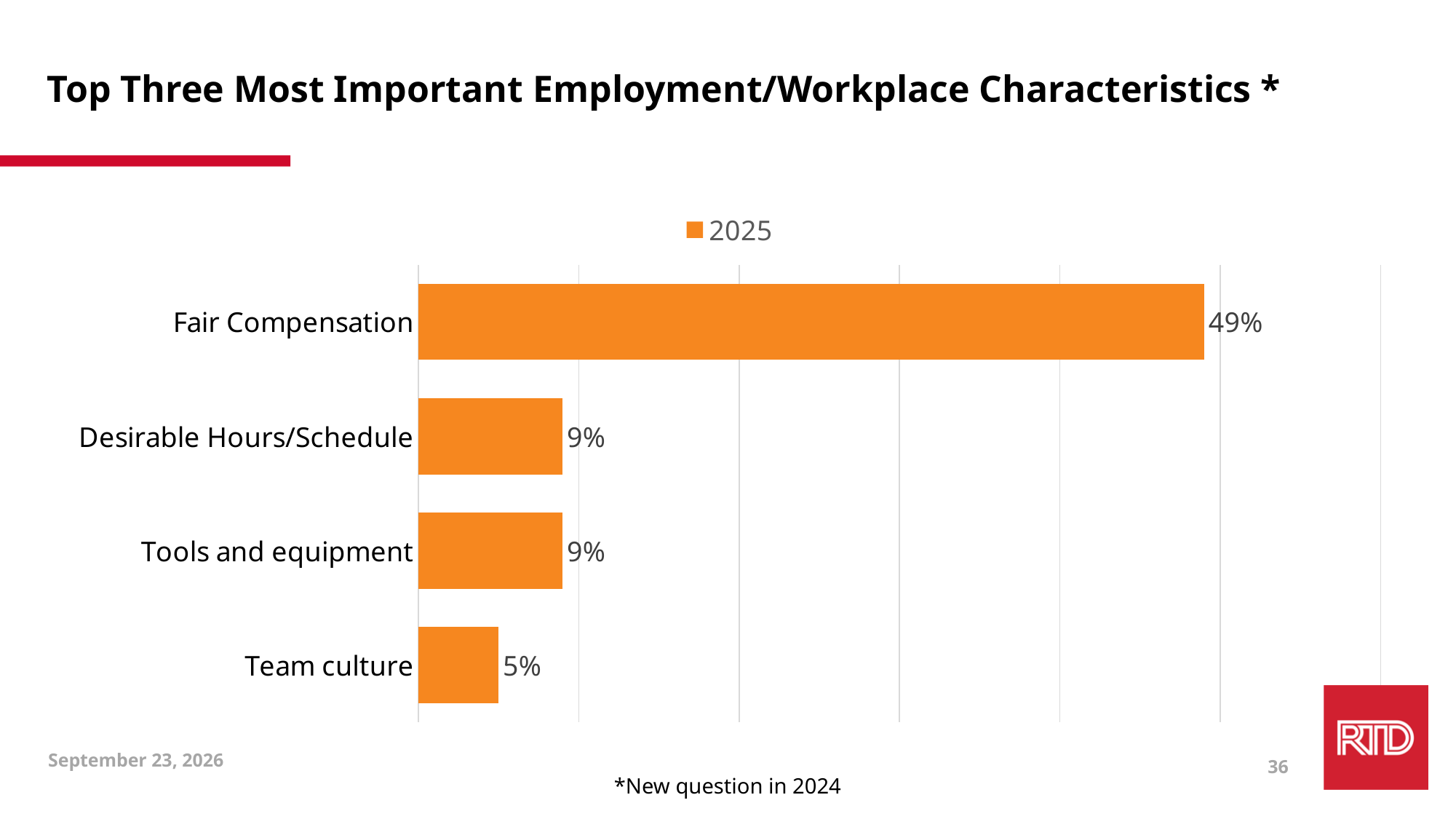
Which is larger, the value for Fair Compensation or the value for Tools and equipment? Fair Compensation What is the value for Team culture? 5% What is the difference between the values for Fair Compensation and Team culture? 44% Which category has the lowest value? Team culture What is the value for Desirable Hours/Schedule? 9% How many categories are shown in the chart? 4 Which category has the highest value? Fair Compensation How many series does the legend list? 1 What is the value for Fair Compensation? 49% What kind of chart is shown on the slide? Bar chart What is the value for Tools and equipment? 9% What is the difference between the values for Desirable Hours/Schedule and Team culture? 4%